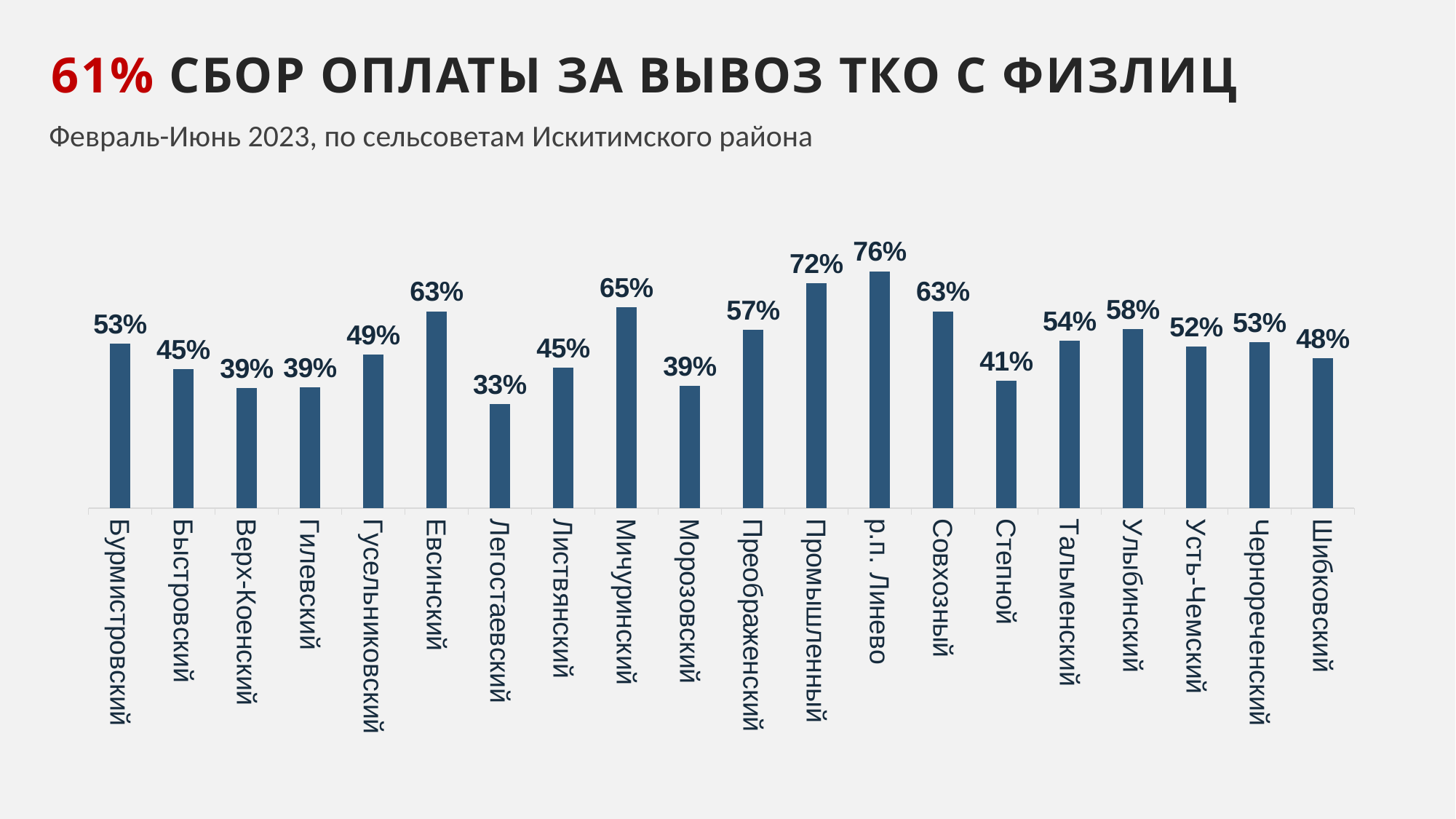
What is the difference between the values for Мичуринский and Степной? 24% What period does the chart subtitle say the data covers? Февраль-Июнь 2023 What is the value for Легостаевский? 33% What is the difference between the values for р.п. Линево and Промышленный? 4% Which is larger, the value for Преображенский or the value for Тальменский? Преображенский What kind of chart is shown on the slide? Bar chart Which category has the highest value? р.п. Линево Which category has the lowest value? Легостаевский Which is larger, the value for Гусельниковский or the value for Шибковский? Гусельниковский How many categories are shown on the chart? 20 What is the value for Улыбинский? 58% What is the value for Промышленный? 72%